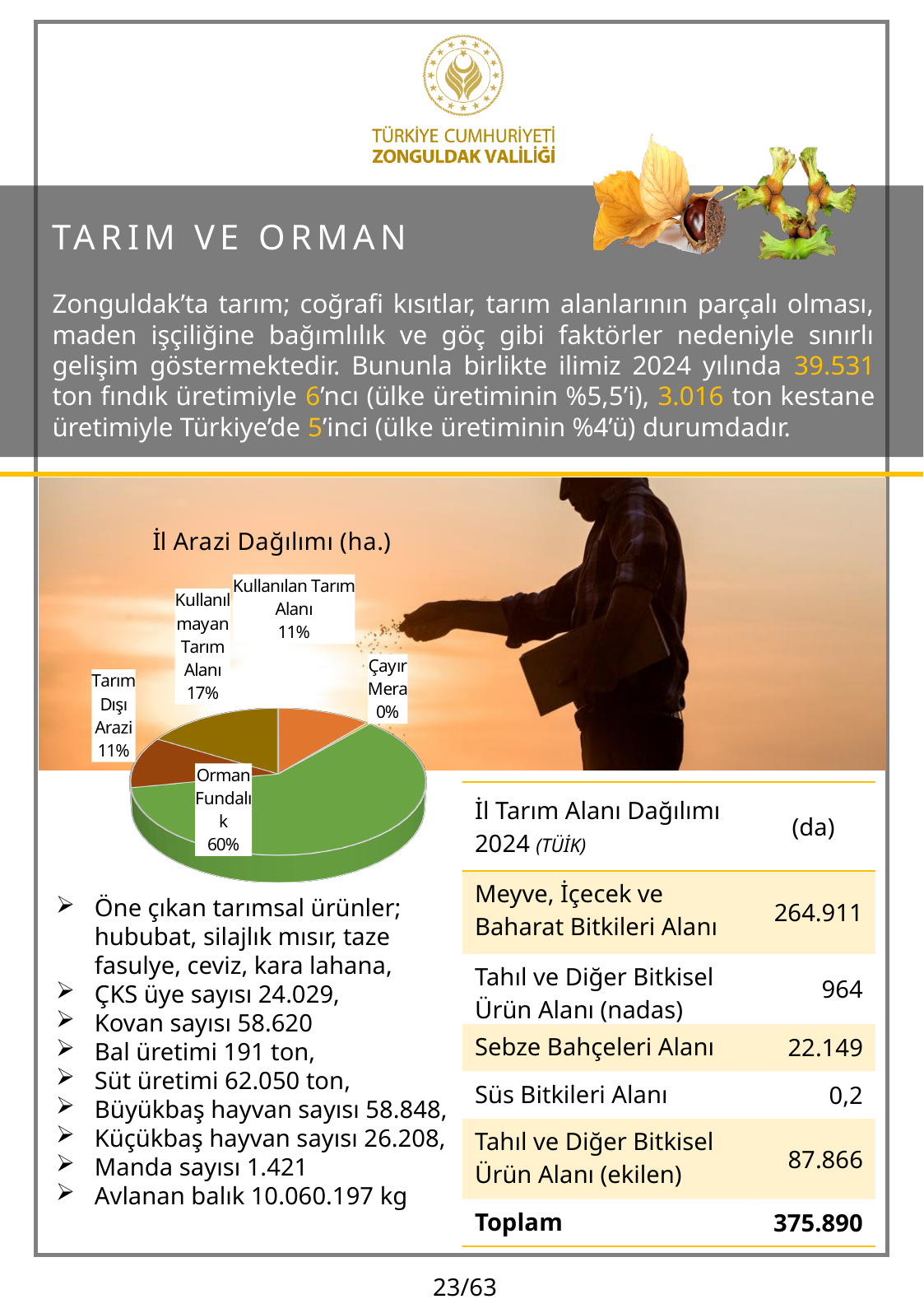
What percentage is shown for Çayır Mera in the pie chart "İl Arazi Dağılımı (ha.)"? 0% What percentage is shown for Tarım Dışı Arazi in the pie chart "İl Arazi Dağılımı (ha.)"? 11% What is the title of the pie chart on the slide? İl Arazi Dağılımı (ha.) What percentage is shown for Kullanılan Tarım Alanı in the pie chart "İl Arazi Dağılımı (ha.)"? 11% In the pie chart "İl Arazi Dağılımı (ha.)", which category has the smallest share? Çayır Mera What share of the pie chart "İl Arazi Dağılımı (ha.)" is Orman Fundalık? 60% In the pie chart "İl Arazi Dağılımı (ha.)", which category has the largest share? Orman Fundalık In the pie chart "İl Arazi Dağılımı (ha.)", which is larger: Kullanılmayan Tarım Alanı or Kullanılan Tarım Alanı? Kullanılmayan Tarım Alanı What kind of chart is shown under the title "İl Arazi Dağılımı (ha.)"? pie chart In the pie chart "İl Arazi Dağılımı (ha.)", what is the difference in percentage points between Orman Fundalık and Kullanılmayan Tarım Alanı? 43 How many slices does the pie chart "İl Arazi Dağılımı (ha.)" have? 5 What percentage is shown for Kullanılmayan Tarım Alanı in the pie chart "İl Arazi Dağılımı (ha.)"? 17%